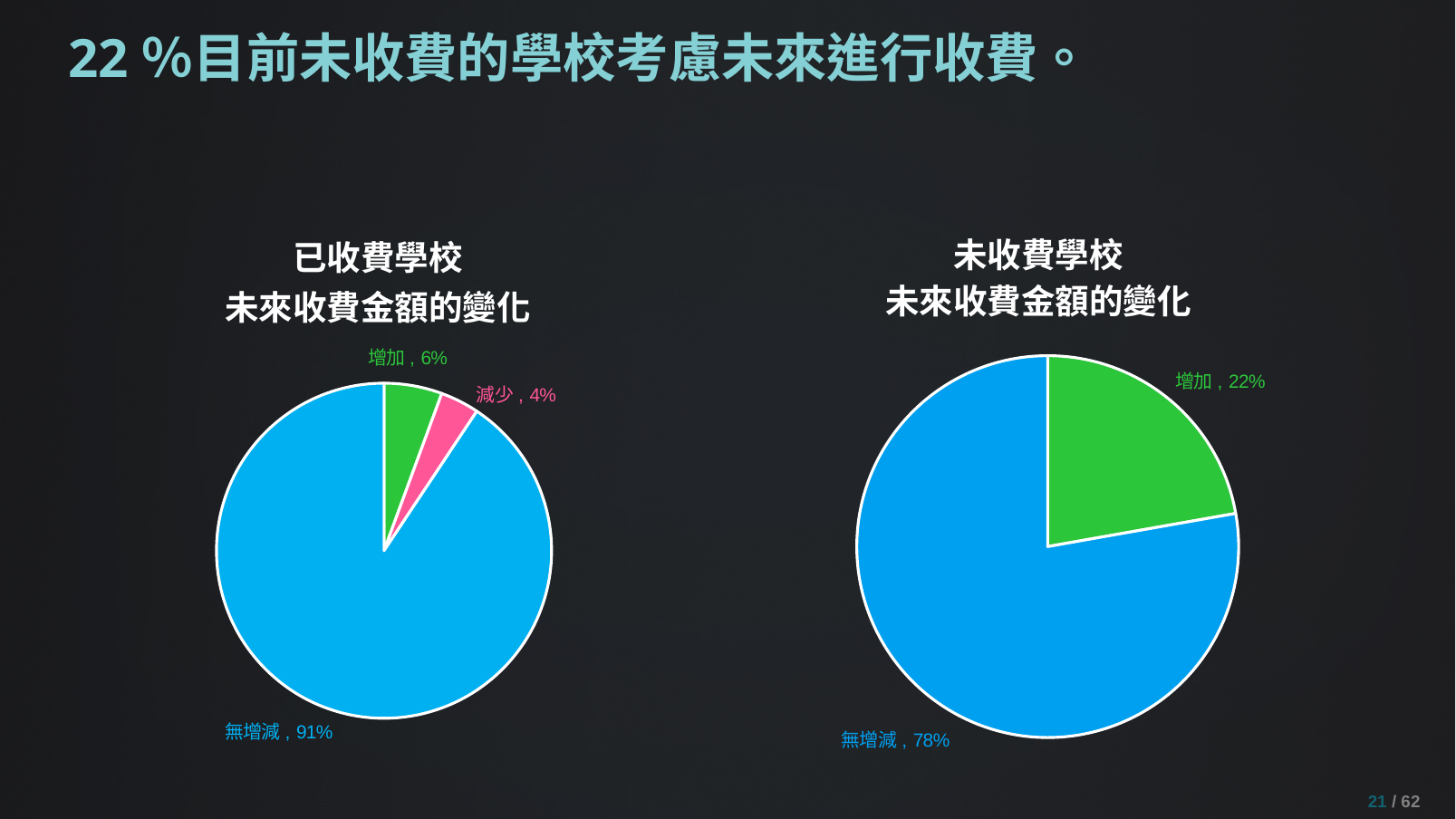
In the right chart titled 未收費學校 未來收費金額的變化, what is the value for 增加? 22% In the left chart titled 已收費學校 未來收費金額的變化, which category has the smallest slice? 減少 In the left chart titled 已收費學校 未來收費金額的變化, what is the difference between 增加 and 減少? 2% What kind of chart is the right chart titled 未收費學校 未來收費金額的變化? Pie chart In the right chart titled 未收費學校 未來收費金額的變化, what is the value for 無增減? 78% In the right chart titled 未收費學校 未來收費金額的變化, which category has the largest slice? 無增減 Which is larger: 增加 in the left chart or 增加 in the right chart? 增加 in the right chart In the right chart titled 未收費學校 未來收費金額的變化, what is the difference between 無增減 and 增加? 56% How many slices does the left chart titled 已收費學校 未來收費金額的變化 have? 3 In the left chart titled 已收費學校 未來收費金額的變化, what is the value for 減少? 4% In the left chart titled 已收費學校 未來收費金額的變化, what is the value for 增加? 6% In the left chart titled 已收費學校 未來收費金額的變化, what is the value for 無增減? 91%